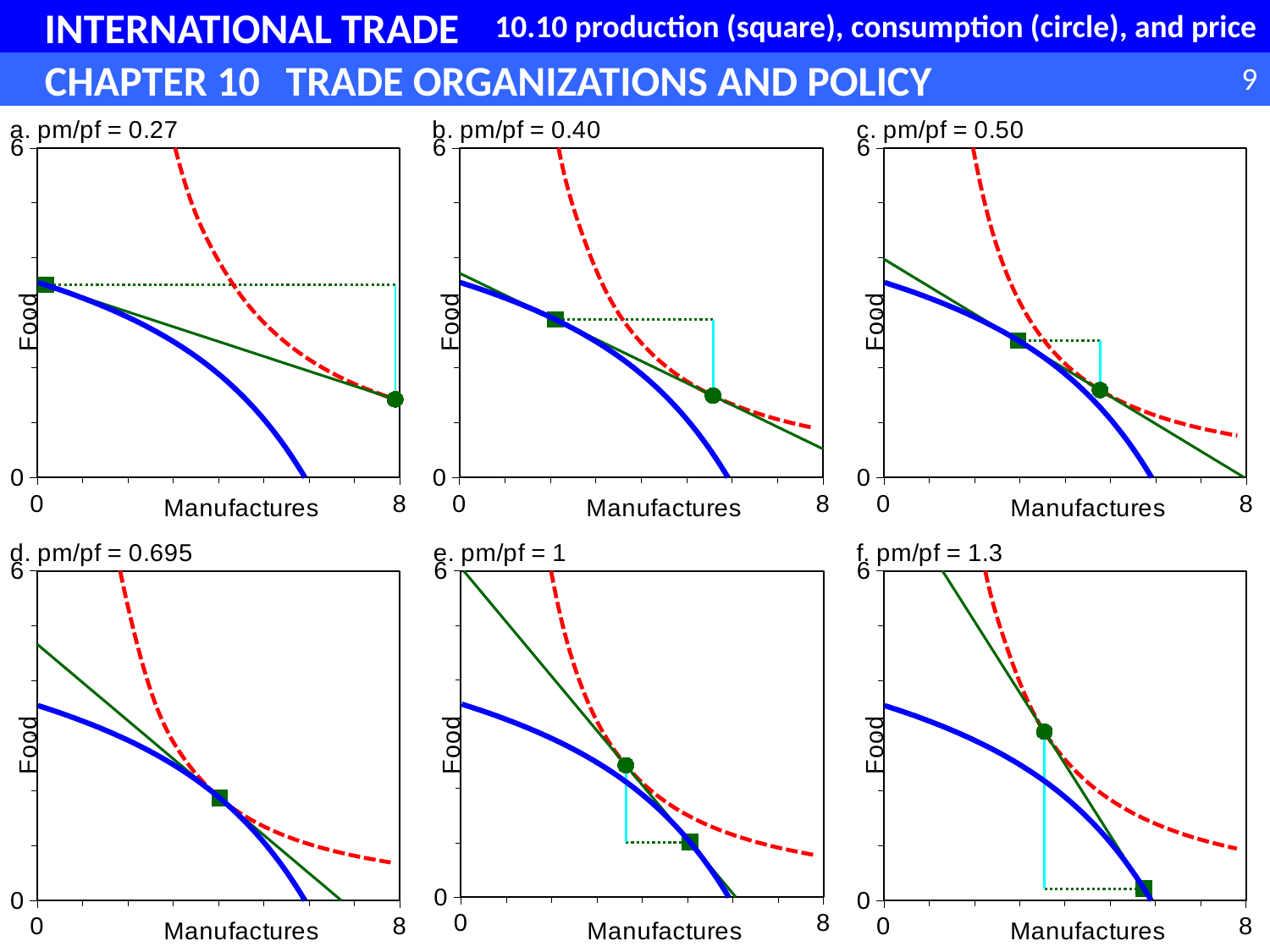
Which panel has the lowest pm/pf value in its title? a (pm/pf = 0.27) What kind of chart is shown in panel a (pm/pf = 0.27)? line chart In panel a (pm/pf = 0.27), which point has the larger Manufactures value, the production square or the consumption circle? consumption circle What is the label of the vertical axis in each panel? Food How many chart panels are shown on the slide? 6 In panel e (pm/pf = 1), does the solid blue curve rise or fall as Manufactures increases? fall Which panel has the highest pm/pf value in its title? f (pm/pf = 1.3) In panel a (pm/pf = 0.27), which point has the larger Food value, the production square or the consumption circle? production square What is the maximum value shown on the Manufactures axis in panel c? 8 What pm/pf value is given in the title of panel d? 0.695 In panel f (pm/pf = 1.3), which point has the larger Food value, the production square or the consumption circle? consumption circle What is the label of the horizontal axis in each panel? Manufactures